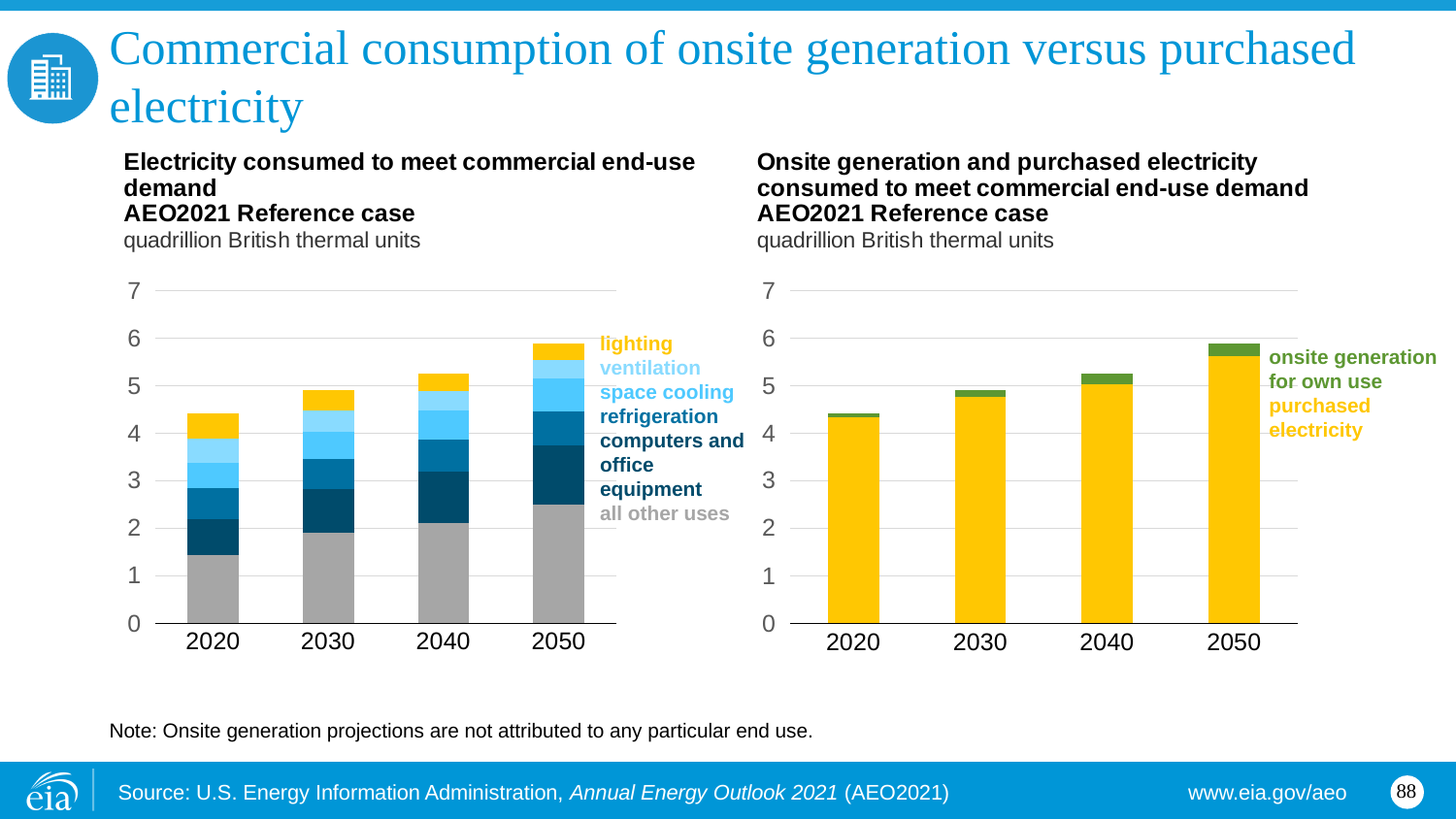
How many years are shown on the x axis of the left chart, 'Electricity consumed to meet commercial end-use demand'? 4 In the left chart, 'Electricity consumed to meet commercial end-use demand', which year has the highest total bar? 2050 How many series does the legend of the left chart, 'Electricity consumed to meet commercial end-use demand', list? 6 What kind of chart is the left chart, 'Electricity consumed to meet commercial end-use demand'? stacked bar chart In the left chart, 'Electricity consumed to meet commercial end-use demand', is the total bar for 2050 greater or less than 5? greater In the right chart, 'Onsite generation and purchased electricity consumed to meet commercial end-use demand', which year has the lowest total bar? 2020 How many series does the legend of the right chart, 'Onsite generation and purchased electricity consumed to meet commercial end-use demand', list? 2 What unit is shown under the titles of both charts? quadrillion British thermal units In the right chart, 'Onsite generation and purchased electricity consumed to meet commercial end-use demand', is the total bar for 2020 greater or less than 5? less In the right chart, 'Onsite generation and purchased electricity consumed to meet commercial end-use demand', which series is larger in 2050: purchased electricity or onsite generation for own use? purchased electricity In the left chart, 'Electricity consumed to meet commercial end-use demand', is the 'all other uses' segment for 2020 greater or less than 2? less In the left chart, 'Electricity consumed to meet commercial end-use demand', do the total bar heights rise or fall from 2020 to 2050? rise